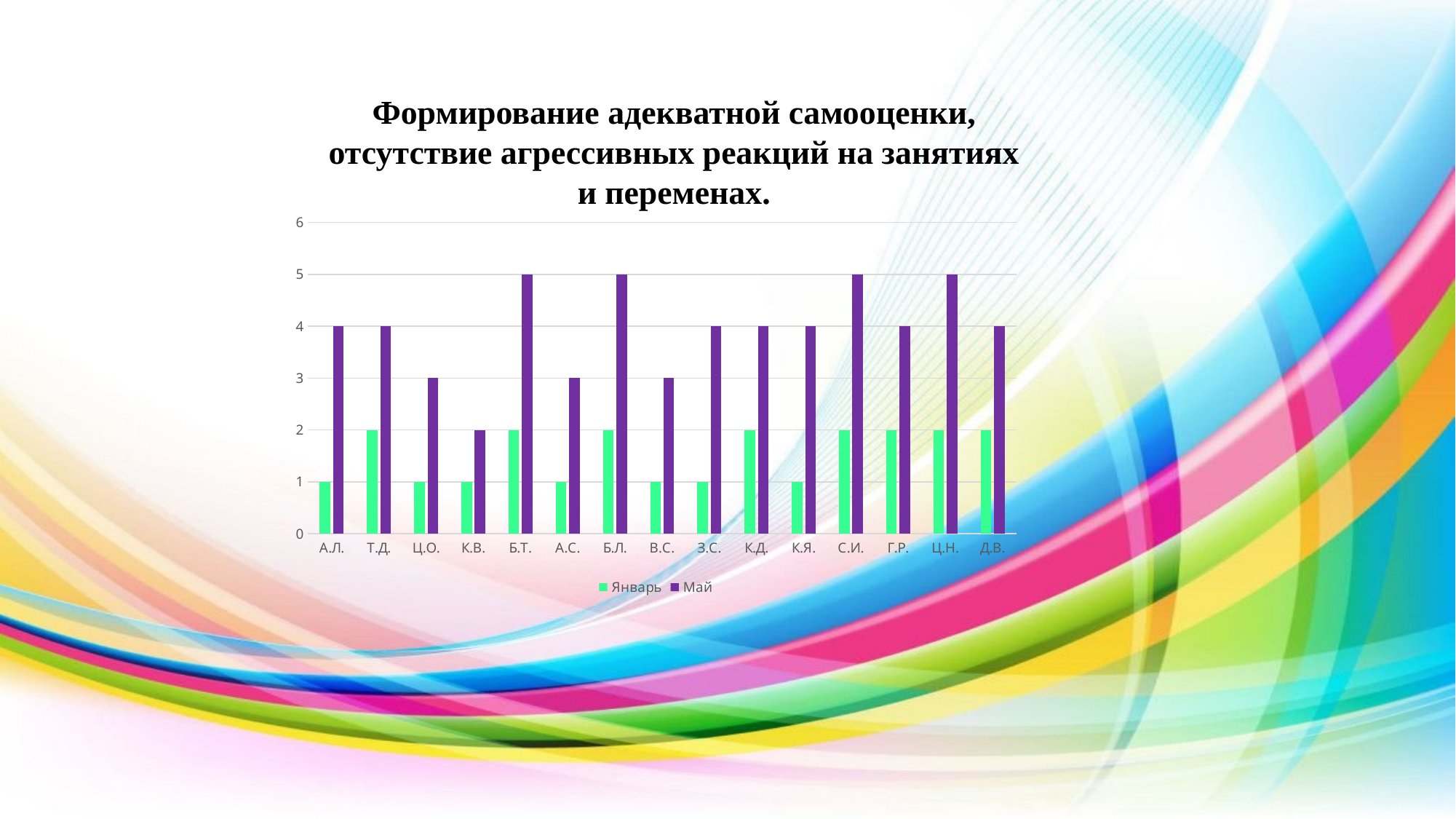
What colour are the bars for the Май series? purple What is the value for Январь for Б.Т.? 2 How many categories are shown on the x axis? 15 What is the difference between the Май and Январь values for Б.Т.? 3 How many series does the legend list? 2 What is the value for Май for Ц.О.? 3 What are the two series named in the legend? Январь and Май Which category has the lowest value for Май? К.В. What kind of chart is shown on the slide? bar chart For А.Л., which is larger: the Январь value or the Май value? Май What is the value for Май for К.В.? 2 Is the value for Май for С.И. greater or less than 4? greater